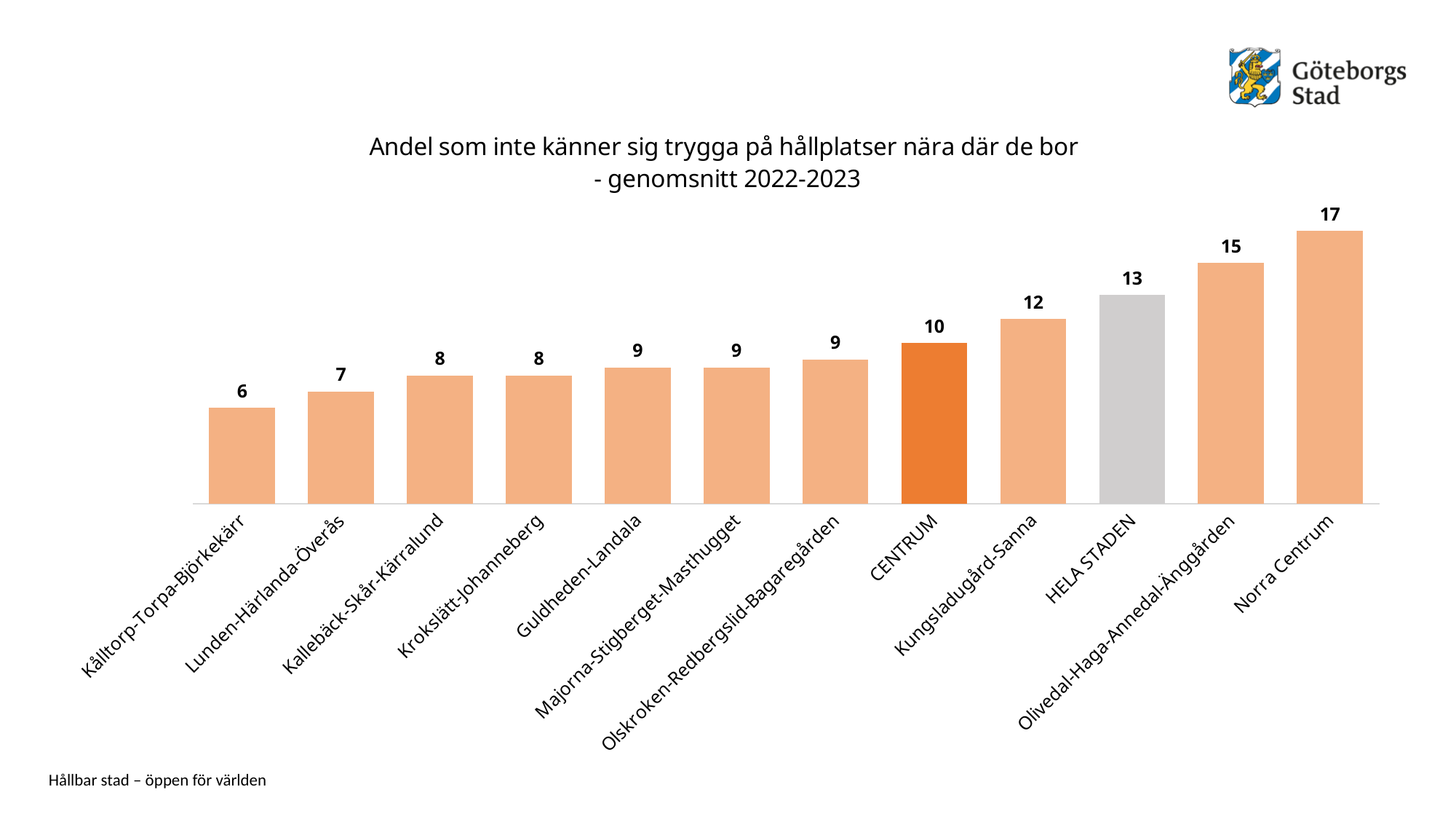
What is the value for Kungsladugård-Sanna? 12 What is the difference between the values for Norra Centrum and Kålltorp-Torpa-Björkekärr? 11 What is the value for HELA STADEN? 13 Which is larger, the value for Olivedal-Haga-Annedal-Änggården or the value for HELA STADEN? Olivedal-Haga-Annedal-Änggården What is the value for Norra Centrum? 17 Do the values rise or fall from left to right along the x axis? Rise How many categories are shown in the chart? 12 What kind of chart is shown on the slide? Bar chart Which category has the highest value? Norra Centrum What is the value for CENTRUM? 10 Which bar is shown in grey? HELA STADEN Which category has the lowest value? Kålltorp-Torpa-Björkekärr